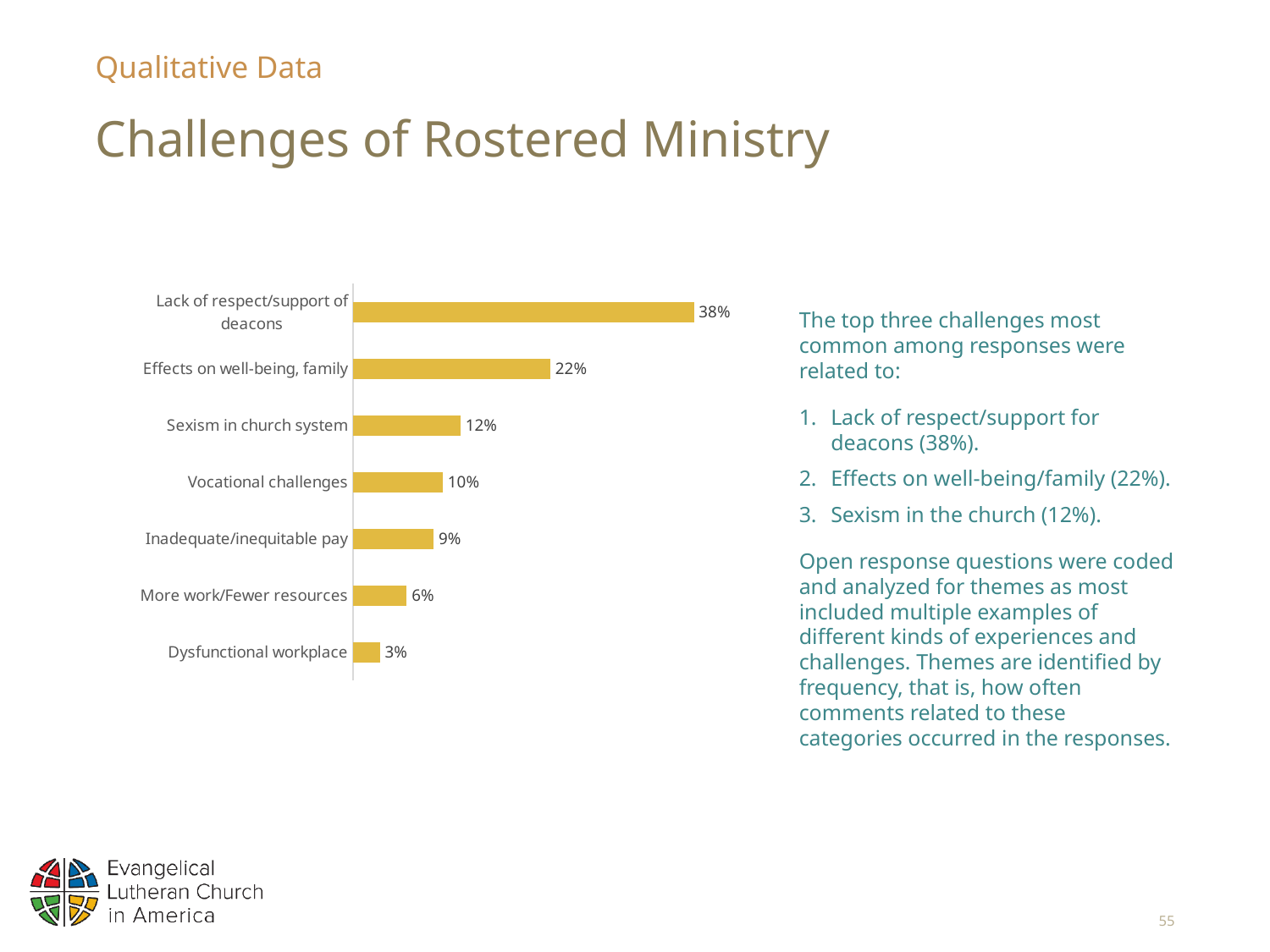
What percentage is shown for "Lack of respect/support of deacons"? 38% Which category has the highest value? Lack of respect/support of deacons What value is shown for "Sexism in church system"? 12% What is the difference between "Vocational challenges" and "Inadequate/inequitable pay"? 1% Which is larger: "Sexism in church system" or "Vocational challenges"? Sexism in church system Which category has the lowest value? Dysfunctional workplace What percentage is shown for "More work/Fewer resources"? 6% What is the value for "Effects on well-being, family"? 22% What colour are the bars in the chart? Yellow/gold What is the difference between "Lack of respect/support of deacons" and "Effects on well-being, family"? 16% How many categories are shown in the chart? 7 What kind of chart is shown on the slide? Bar chart